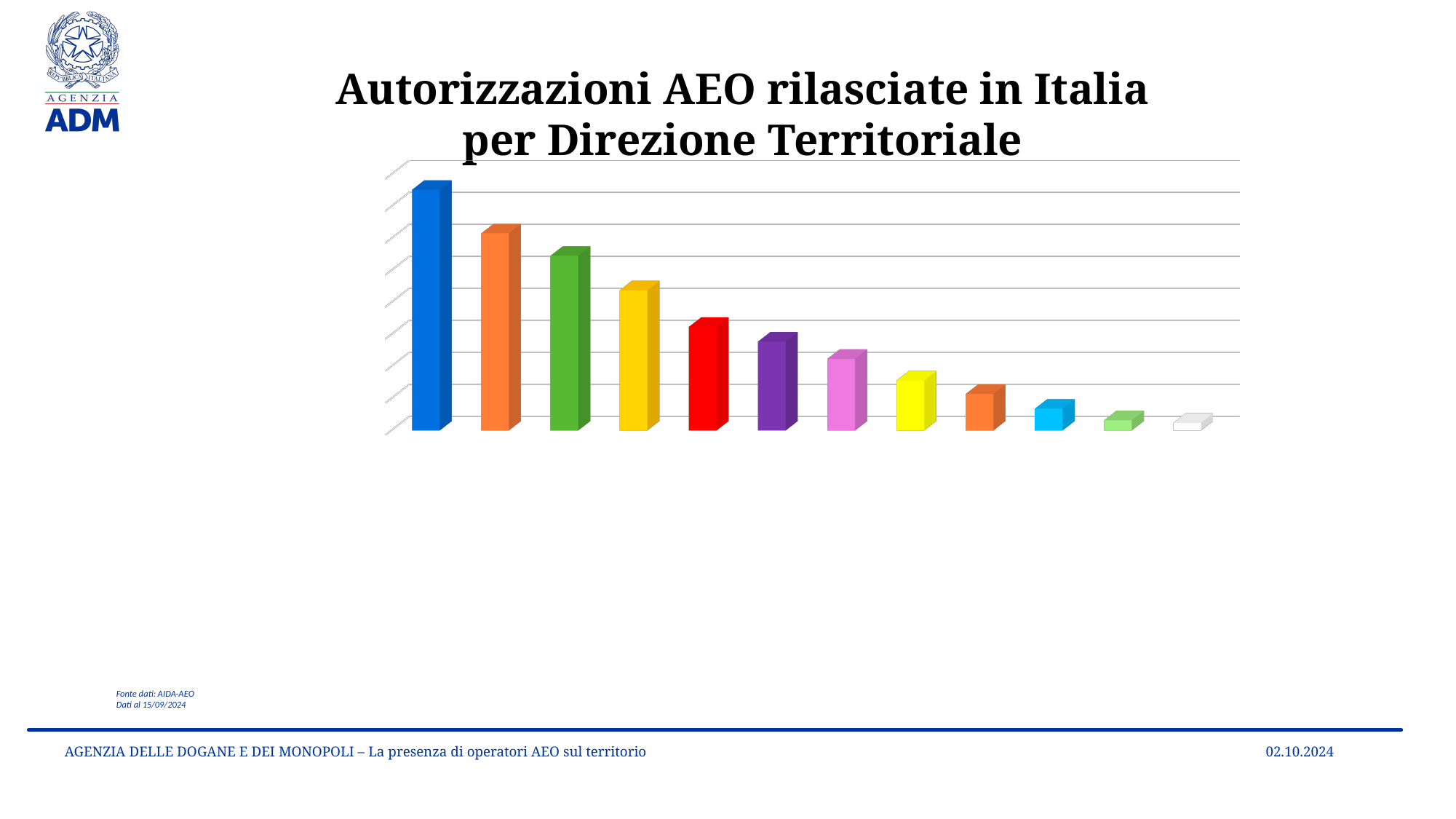
Is the fifth bar from the left (red) taller or shorter than the fourth bar from the left (yellow)? shorter How many bars does the chart contain? 12 Do the bar values rise or fall from left to right across the chart? fall Which bar is the tallest: the leftmost bar or the rightmost bar? the leftmost bar What colour is the tallest bar in the chart? blue What is the title of the chart? Autorizzazioni AEO rilasciate in Italia per Direzione Territoriale Is the first bar from the left taller or shorter than the second bar from the left? taller What kind of chart is shown on the slide? bar chart Is the rightmost bar the shortest bar in the chart? yes